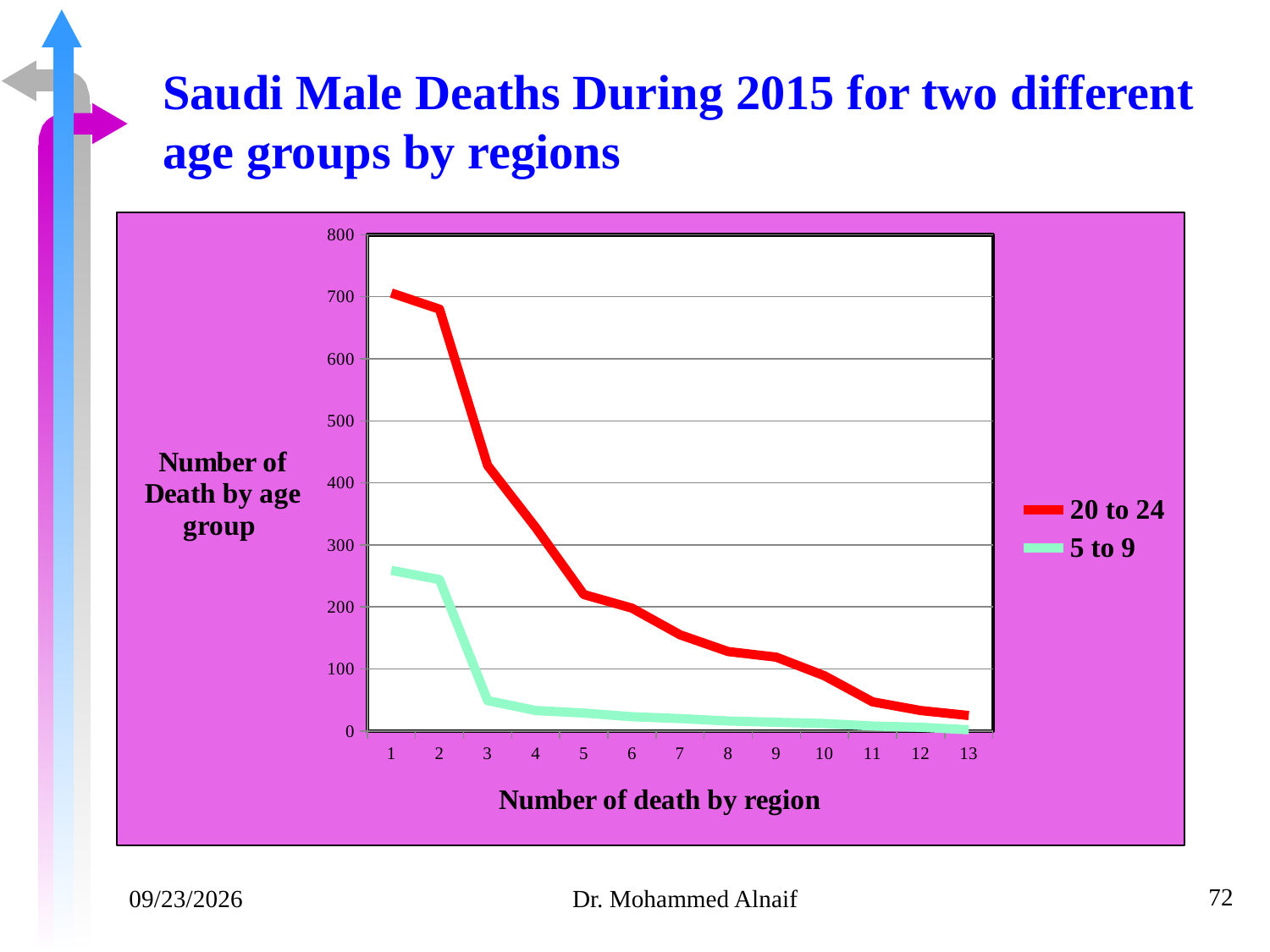
Is the value for the 5 to 9 series at region 1 greater or less than 200? greater Which region has the lowest value for the 5 to 9 series? 13 How many series does the legend list? 2 Is the value for the 20 to 24 series at region 13 greater or less than 100? less Which region has the highest value for the 20 to 24 series? 1 What is the title of the x axis? Number of death by region What kind of chart is shown on the slide? line chart How many regions are plotted along the x axis? 13 Which colour represents the 5 to 9 series in the legend? light green Is the value for the 20 to 24 series at region 1 greater or less than 600? greater At region 1, which series has the larger value, 20 to 24 or 5 to 9? 20 to 24 Do the values for the 20 to 24 series rise or fall as the region number increases from 1 to 13? fall